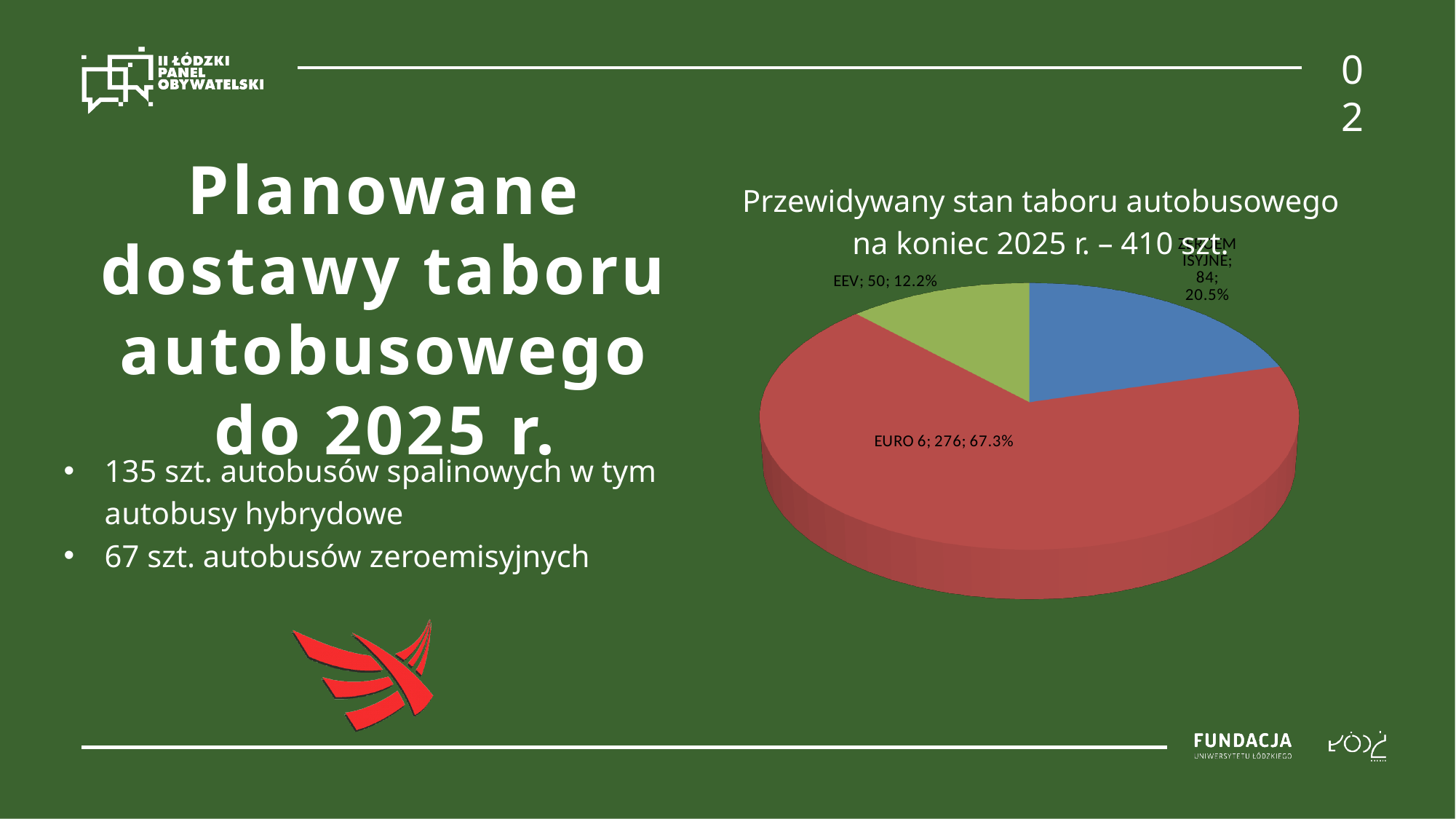
According to the chart title, what is the total number of buses expected at the end of 2025? 410 szt. Which category has the largest slice in the pie chart? EURO 6 What share of the pie does the blue slice represent? 20.5% What share of the pie does the EURO 6 slice represent? 67.3% What is the value shown for the blue slice of the pie chart? 84 What is the difference between the EURO 6 value and the EEV value? 226 How many slices does the pie chart have? 3 What is the value for EURO 6 in the pie chart? 276 Which category has the smallest slice in the pie chart? EEV What is the value for EEV in the pie chart? 50 What kind of chart is shown on the slide? pie chart What share of the pie does the EEV slice represent? 12.2%